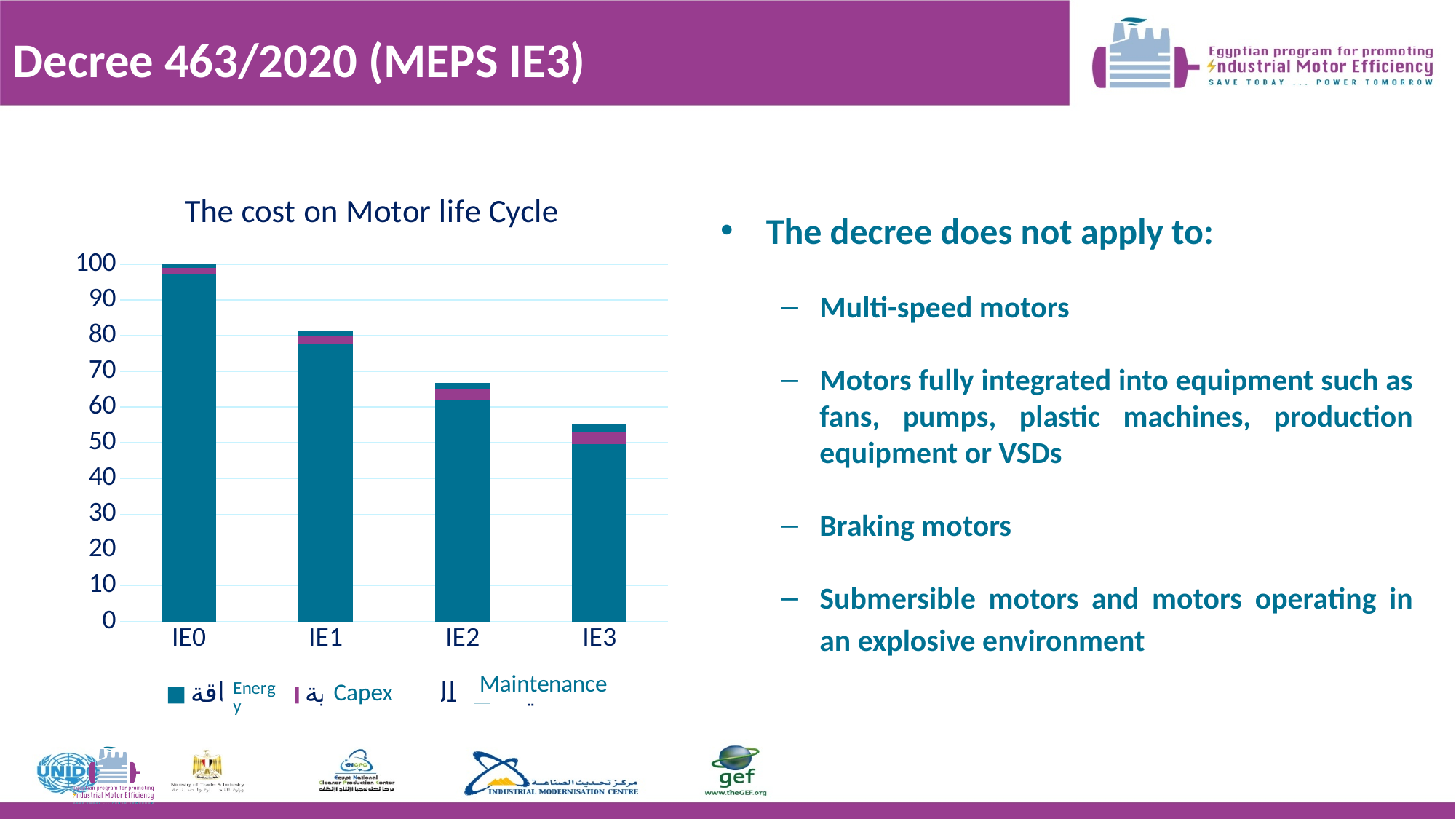
Which series makes up the largest part of each bar in the chart? Energy Do the total bar heights rise or fall from IE0 to IE3? Fall Which has a larger total cost, IE1 or IE2? IE1 Is the total value for IE3 greater or less than 60? less Which category has the highest total cost in the chart? IE0 Which category has the lowest total cost in the chart? IE3 Is the total value for IE2 greater or less than 70? less How many series does the chart's legend list? 3 How many motor efficiency classes (categories) are shown on the x axis of the chart? 4 What type of chart is shown on the slide? Stacked bar chart Is the total value for IE1 greater or less than 70? greater What is the title of the chart? The cost on Motor life Cycle